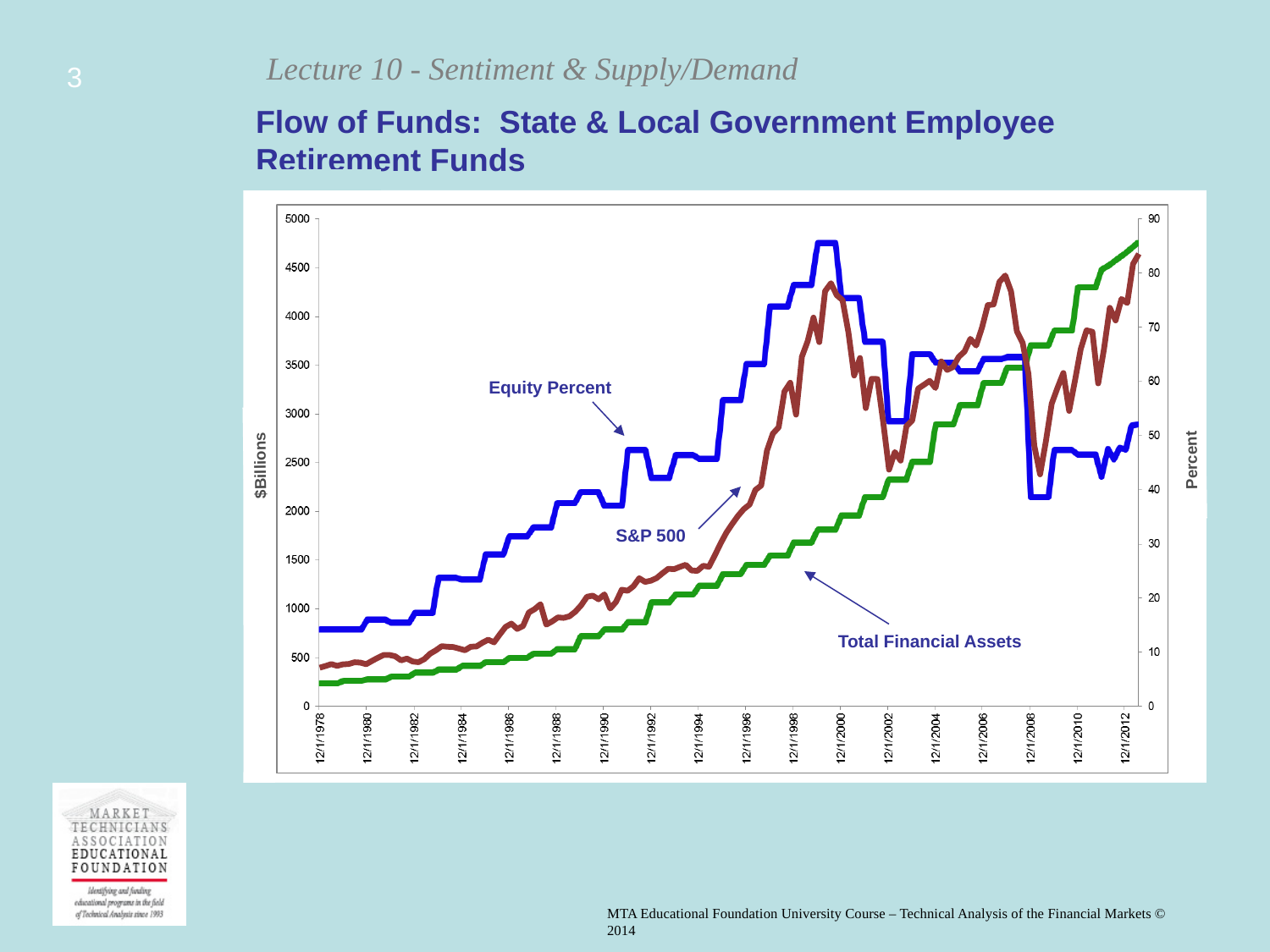
Which series is drawn as the green line? Total Financial Assets Is the S&P 500 value at 12/1/1978 greater or less than 1000 on the $Billions axis? less Is the low point of the Equity Percent line around 12/1/2008 greater or less than 50 on the Percent axis? less Is the Equity Percent value at 12/1/1978 greater or less than 20 on the Percent axis? less What is the label of the left vertical axis? $Billions What kind of chart is shown on the slide? line chart Which is larger for Total Financial Assets: the value at 12/1/2012 or the value at 12/1/1978? 12/1/2012 Does the Total Financial Assets line generally rise or fall from 12/1/1978 to 12/1/2012? rise How many data series are plotted on the chart? 3